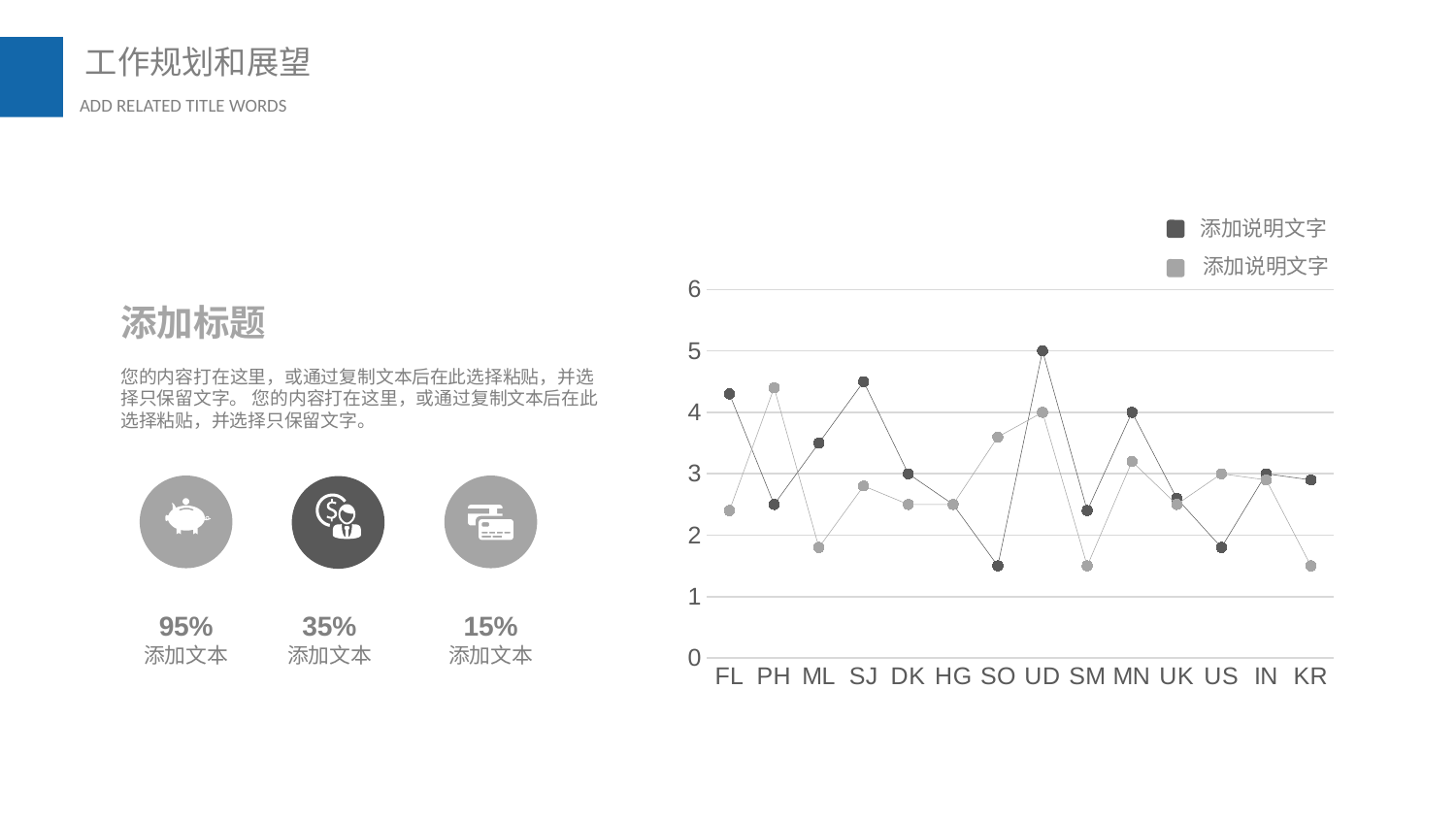
How many categories are shown on the x axis of the chart? 14 Is the value of the dark gray series at SO greater or less than 2? less At FL, which series has the larger value, the dark gray or the light gray? dark gray Is the value of the light gray series at SM greater or less than 2? less How many series does the chart's legend list? 2 At PH, which series has the larger value, the dark gray or the light gray? light gray At which category does the dark gray series reach its highest value? UD At which category does the light gray series reach its highest value? PH What is the value of the dark gray series at MN? 4 What kind of chart is shown on the slide? line chart Is the value of the dark gray series at FL greater or less than 4? greater What is the value of the dark gray series at UD? 5